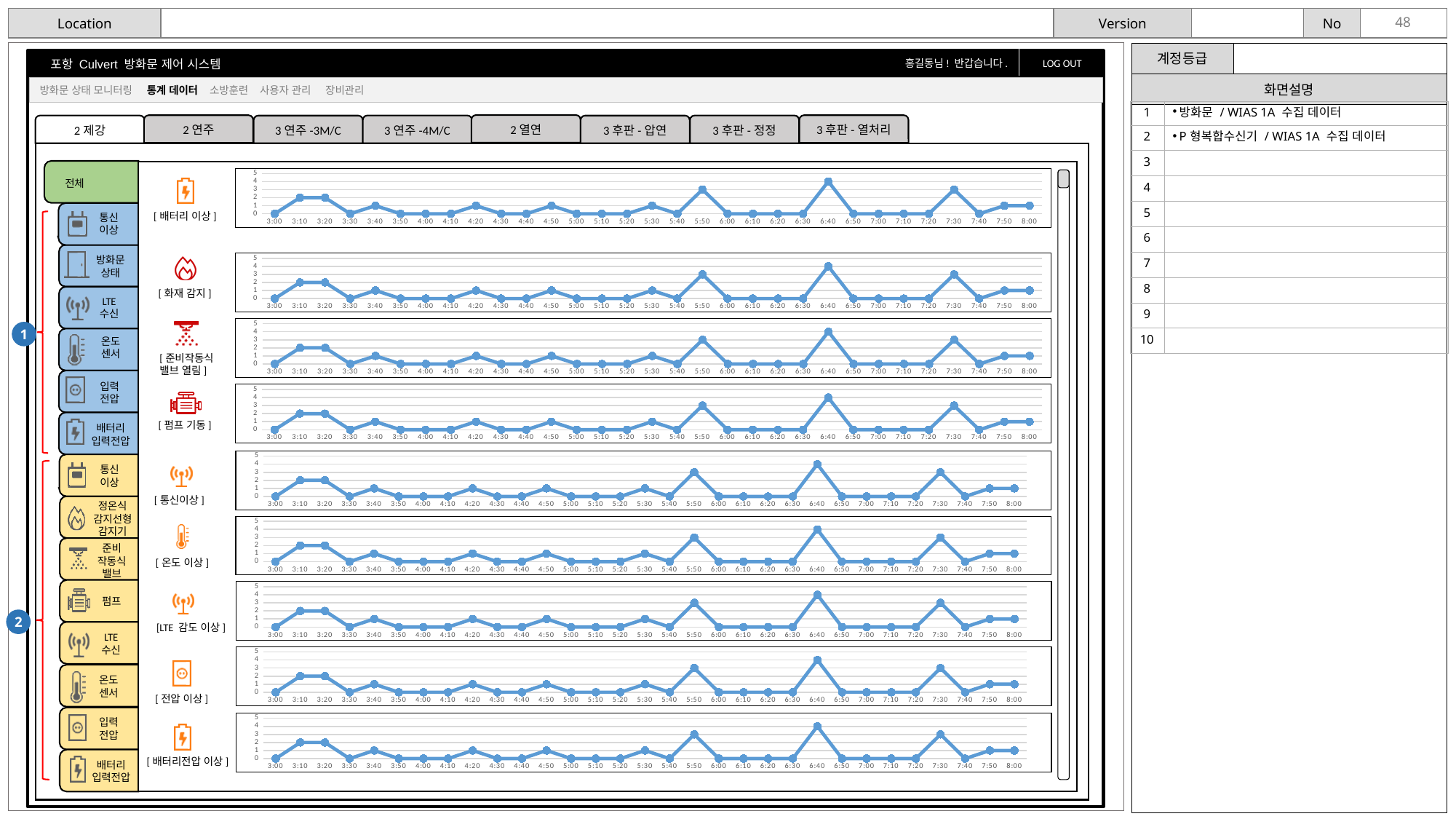
In the [화재 감지] chart, is the value at 4:00 greater or less than 1? less In the [통신이상] chart, which is larger, the value at 5:50 or the value at 6:40? 6:40 How many line charts are shown on the slide? 9 What is the last time label on the x axis of the [배터리전압 이상] chart? 8:00 In the [온도 이상] chart, which is larger, the value at 3:10 or the value at 3:30? 3:10 What kind of chart is used for the [배터리 이상] panel? line chart In the [배터리 이상] chart, at which time does the line reach its highest point? 6:40 In the [준비작동식 밸브 열림] chart, is the value at 7:30 greater or less than 2? greater How many time points are plotted along the x axis of the [LTE 감도 이상] chart? 31 In the [펌프 기동] chart, is the value at 3:00 greater or less than 1? less What is the first time label on the x axis of the [전압 이상] chart? 3:00